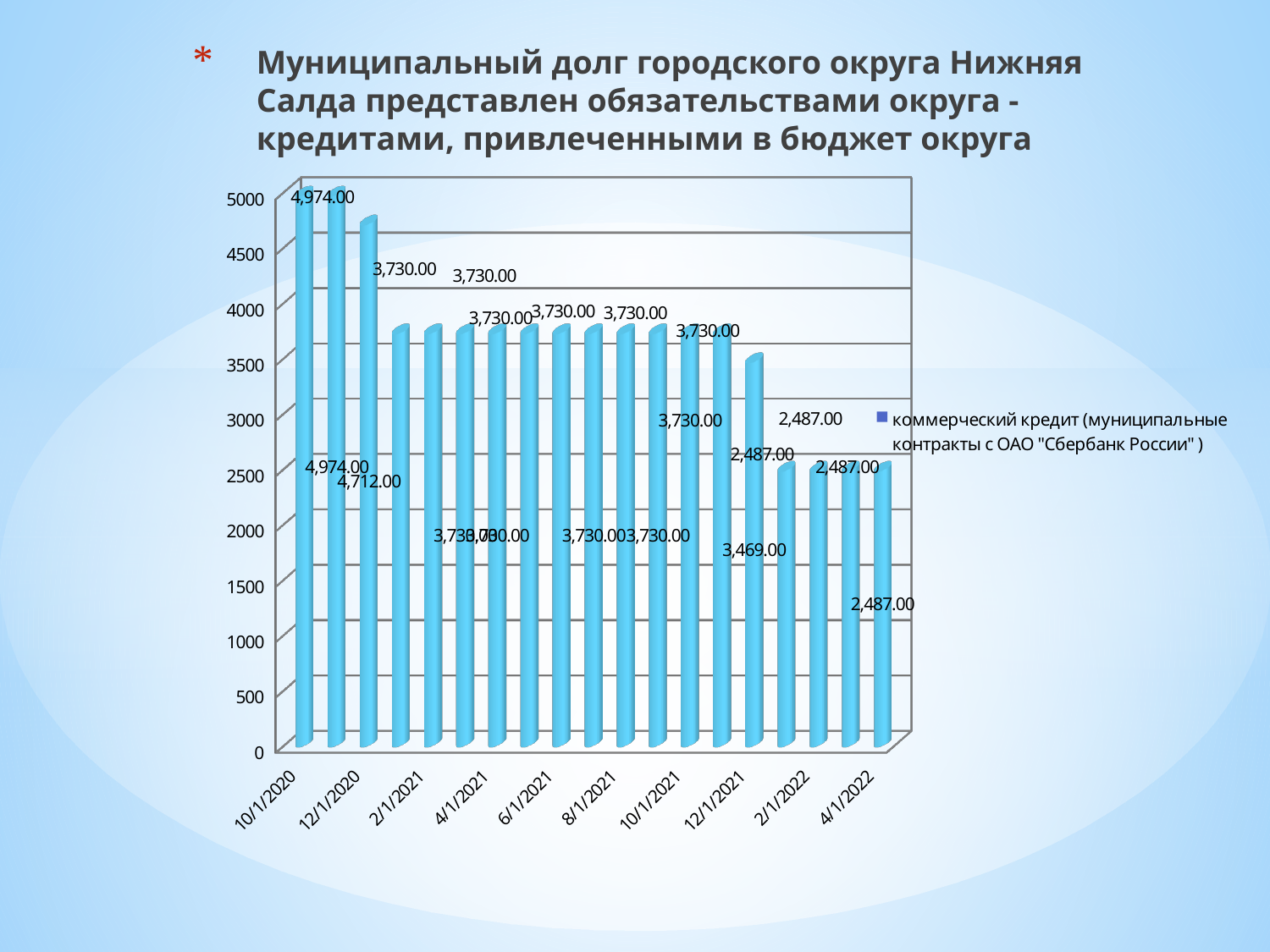
What is the value for 6/1/2021? 3,730.00 Is the value for 2/1/2022 greater or less than 3000? less What is the lowest value shown in the chart? 2,487.00 What is the highest value shown in the chart? 4,974.00 Which is larger, the value for 12/1/2020 or the value for 2/1/2022? 12/1/2020 What is the value for 12/1/2020? 4,712.00 Do the values generally rise or fall from 10/1/2020 to 4/1/2022? fall What is the value for 12/1/2021? 3,469.00 What is the difference between the value for 10/1/2020 and the value for 4/1/2022? 2,487.00 What is the value for 10/1/2020? 4,974.00 What is the difference between the value for 12/1/2020 and the value for 12/1/2021? 1,243.00 What is the value for 4/1/2022? 2,487.00